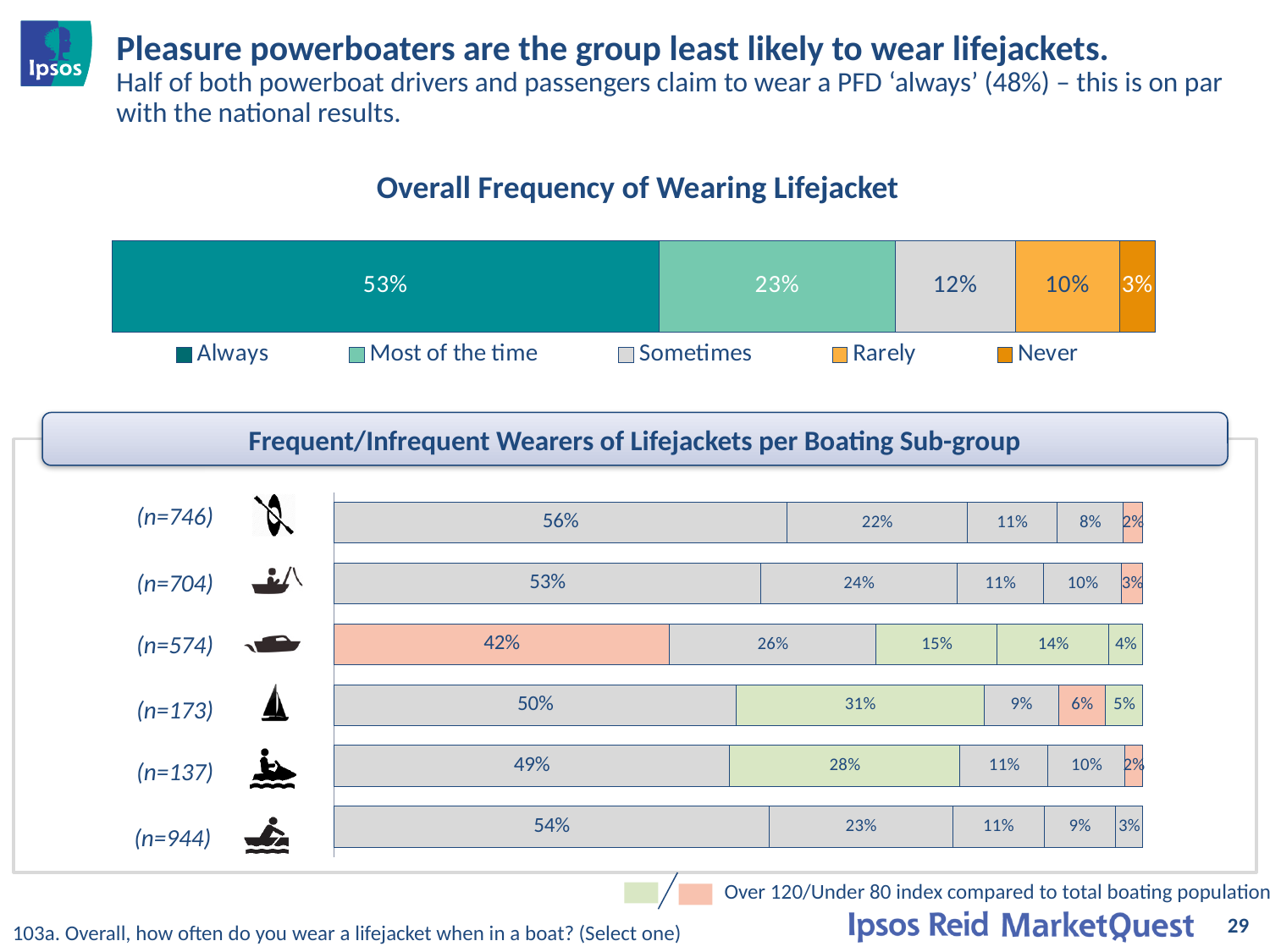
In the 'Overall Frequency of Wearing Lifejacket' chart, what is the difference between the 'Always' and 'Most of the time' values? 30 percentage points In the 'Frequent/Infrequent Wearers of Lifejackets per Boating Sub-group' chart, which has the larger leftmost segment: the (n=746) sub-group or the (n=574) sub-group? (n=746) In the 'Overall Frequency of Wearing Lifejacket' chart, which category has the smallest share? Never In the 'Overall Frequency of Wearing Lifejacket' chart, what is the value for 'Rarely'? 10% What kind of chart is the 'Overall Frequency of Wearing Lifejacket' chart? Stacked bar chart How many categories does the legend of the 'Overall Frequency of Wearing Lifejacket' chart list? 5 In the 'Frequent/Infrequent Wearers of Lifejackets per Boating Sub-group' chart, what is the first (leftmost) segment value for the (n=574) sub-group? 42% In the 'Overall Frequency of Wearing Lifejacket' chart, what percentage of respondents say they 'Always' wear a lifejacket? 53% How many boating sub-groups are shown in the 'Frequent/Infrequent Wearers of Lifejackets per Boating Sub-group' chart? 6 In the 'Frequent/Infrequent Wearers of Lifejackets per Boating Sub-group' chart, which sub-group has the lowest leftmost segment value? (n=574) In the 'Frequent/Infrequent Wearers of Lifejackets per Boating Sub-group' chart, what is the second segment value for the (n=173) sub-group? 31% In the 'Overall Frequency of Wearing Lifejacket' chart, which category has the largest share? Always